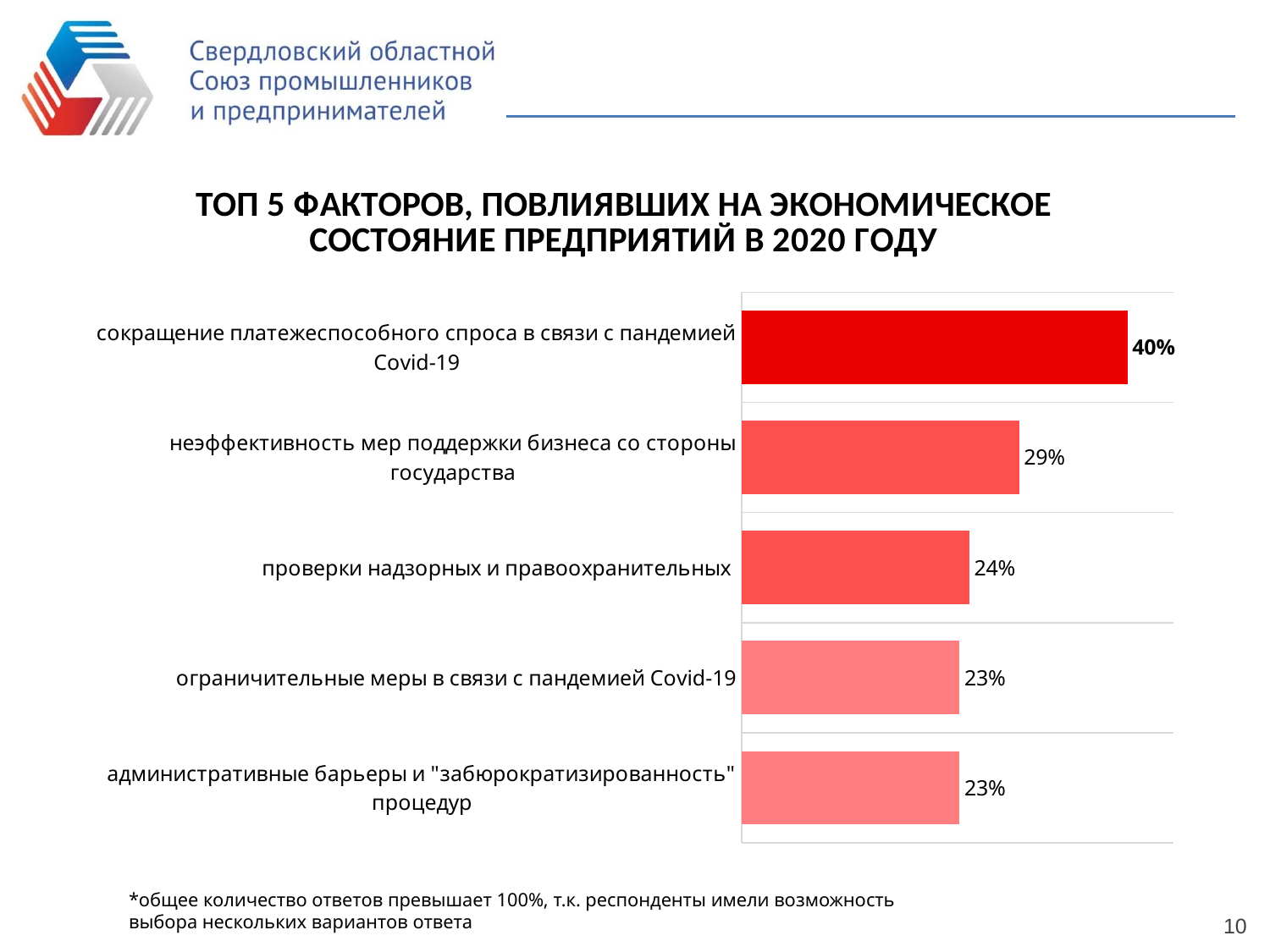
What is the title of the chart on the slide? ТОП 5 ФАКТОРОВ, ПОВЛИЯВШИХ НА ЭКОНОМИЧЕСКОЕ СОСТОЯНИЕ ПРЕДПРИЯТИЙ В 2020 ГОДУ What value is shown for "ограничительные меры в связи с пандемией Covid-19"? 23% What is the difference between the values for "сокращение платежеспособного спроса в связи с пандемией Covid-19" and "неэффективность мер поддержки бизнеса со стороны государства"? 11% What kind of chart is shown on the slide? bar chart What value is shown for "неэффективность мер поддержки бизнеса со стороны государства"? 29% Which two factors share the same value of 23%? ограничительные меры в связи с пандемией Covid-19; административные барьеры и "забюрократизированность" процедур How many factors are shown in the chart? 5 What is the difference between the values for "проверки надзорных и правоохранительных" and "ограничительные меры в связи с пандемией Covid-19"? 1% What value is shown for "проверки надзорных и правоохранительных"? 24% Which is larger: the value for "неэффективность мер поддержки бизнеса со стороны государства" or for "проверки надзорных и правоохранительных"? неэффективность мер поддержки бизнеса со стороны государства Which factor has the highest value? сокращение платежеспособного спроса в связи с пандемией Covid-19 What value is shown for "сокращение платежеспособного спроса в связи с пандемией Covid-19"? 40%